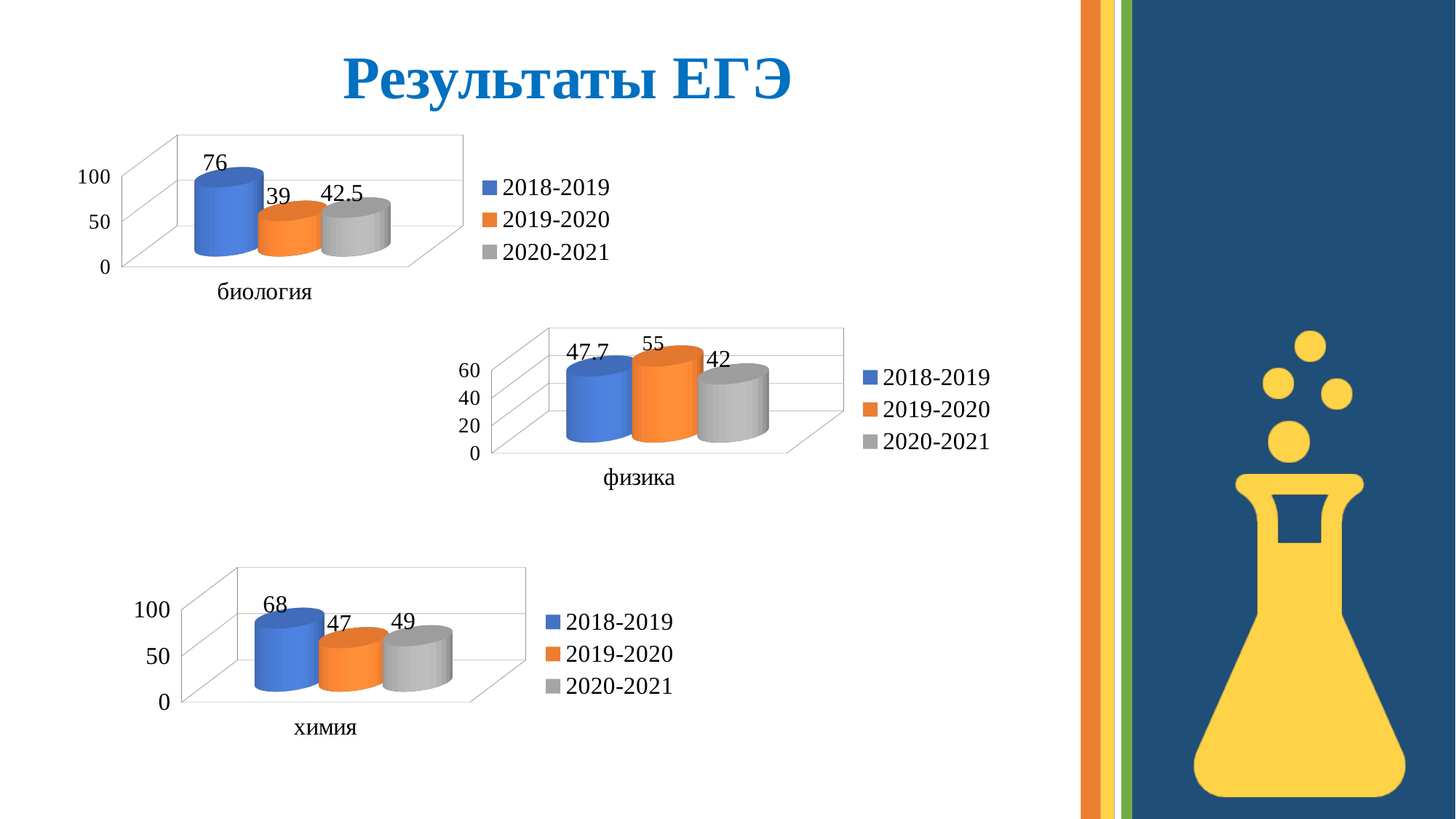
In the биология chart, what is the value for 2020-2021? 42.5 What kind of chart is the физика chart? bar chart In the биология chart, what is the value for 2018-2019? 76 In the химия chart, which is larger: the value for 2020-2021 or the value for 2019-2020? 2020-2021 How many series does the legend of the биология chart list? 3 In the химия chart, what is the difference between the 2018-2019 value and the 2019-2020 value? 21 In the биология chart, which series has the highest value? 2018-2019 In the физика chart, which series has the lowest value? 2020-2021 In the физика chart, what is the difference between the 2019-2020 value and the 2018-2019 value? 7.3 In the физика chart, what is the value for 2019-2020? 55 In the химия chart, what is the value for 2019-2020? 47 What is the title of the slide? Результаты ЕГЭ